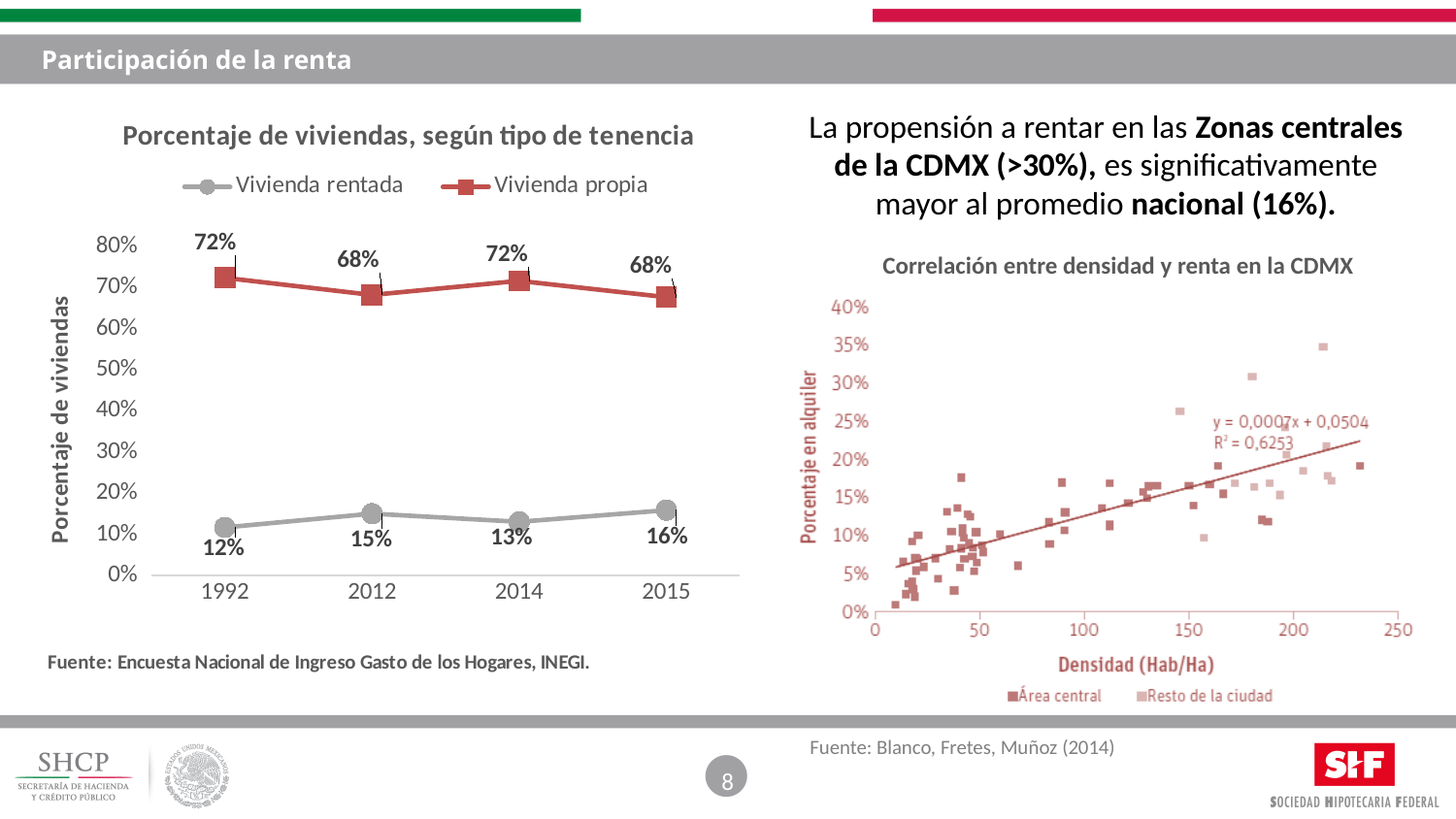
In the chart 'Porcentaje de viviendas, según tipo de tenencia', what is the value for Vivienda rentada in 2015? 16% In the chart 'Porcentaje de viviendas, según tipo de tenencia', how many years are shown on the x axis? 4 In the chart 'Porcentaje de viviendas, según tipo de tenencia', what is the value for Vivienda propia in 1992? 72% What kind of chart is 'Porcentaje de viviendas, según tipo de tenencia'? Line chart In the chart 'Correlación entre densidad y renta en la CDMX', what is the R² value shown for the trendline? 0,6253 In the chart 'Porcentaje de viviendas, según tipo de tenencia', what is the difference between Vivienda propia and Vivienda rentada in 2012? 53% In the chart 'Correlación entre densidad y renta en la CDMX', what is the label of the x axis? Densidad (Hab/Ha) What kind of chart is 'Correlación entre densidad y renta en la CDMX'? Scatter chart In the chart 'Porcentaje de viviendas, según tipo de tenencia', how many series does the legend list? 2 In the chart 'Porcentaje de viviendas, según tipo de tenencia', in which year is Vivienda rentada lowest? 1992 In the chart 'Porcentaje de viviendas, según tipo de tenencia', what is the value for Vivienda rentada in 2014? 13% In the chart 'Porcentaje de viviendas, según tipo de tenencia', which is larger in 2015: Vivienda rentada or Vivienda propia? Vivienda propia